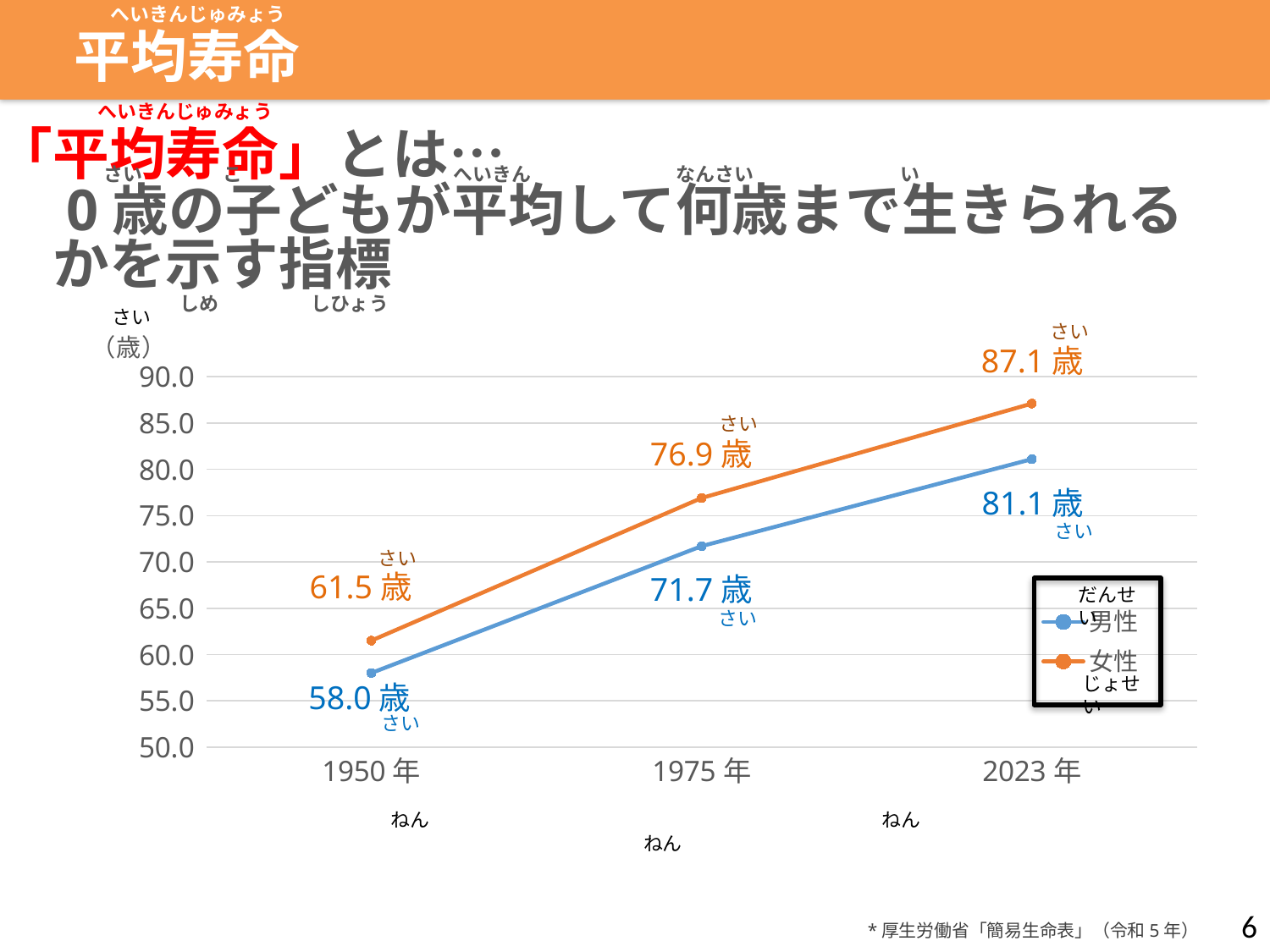
What is the value for 男性 (men) in 2023 年? 81.1 歳 What is the value for 男性 (men) in 1950 年? 58.0 歳 What is the value for 女性 (women) in 2023 年? 87.1 歳 Which is larger in 1975 年, the value for 男性 or for 女性? 女性 How many years (x-axis categories) are plotted on the chart? 3 How many series does the legend list? 2 By how much did the 男性 value increase from 1950 年 to 2023 年? 23.1 歳 What is the value for 女性 (women) in 1975 年? 76.9 歳 What is the difference between the 女性 and 男性 values in 2023 年? 6.0 歳 In which year is the value for 男性 (men) lowest? 1950 年 What kind of chart is shown on the slide? Line chart In which year is the value for 女性 (women) highest? 2023 年